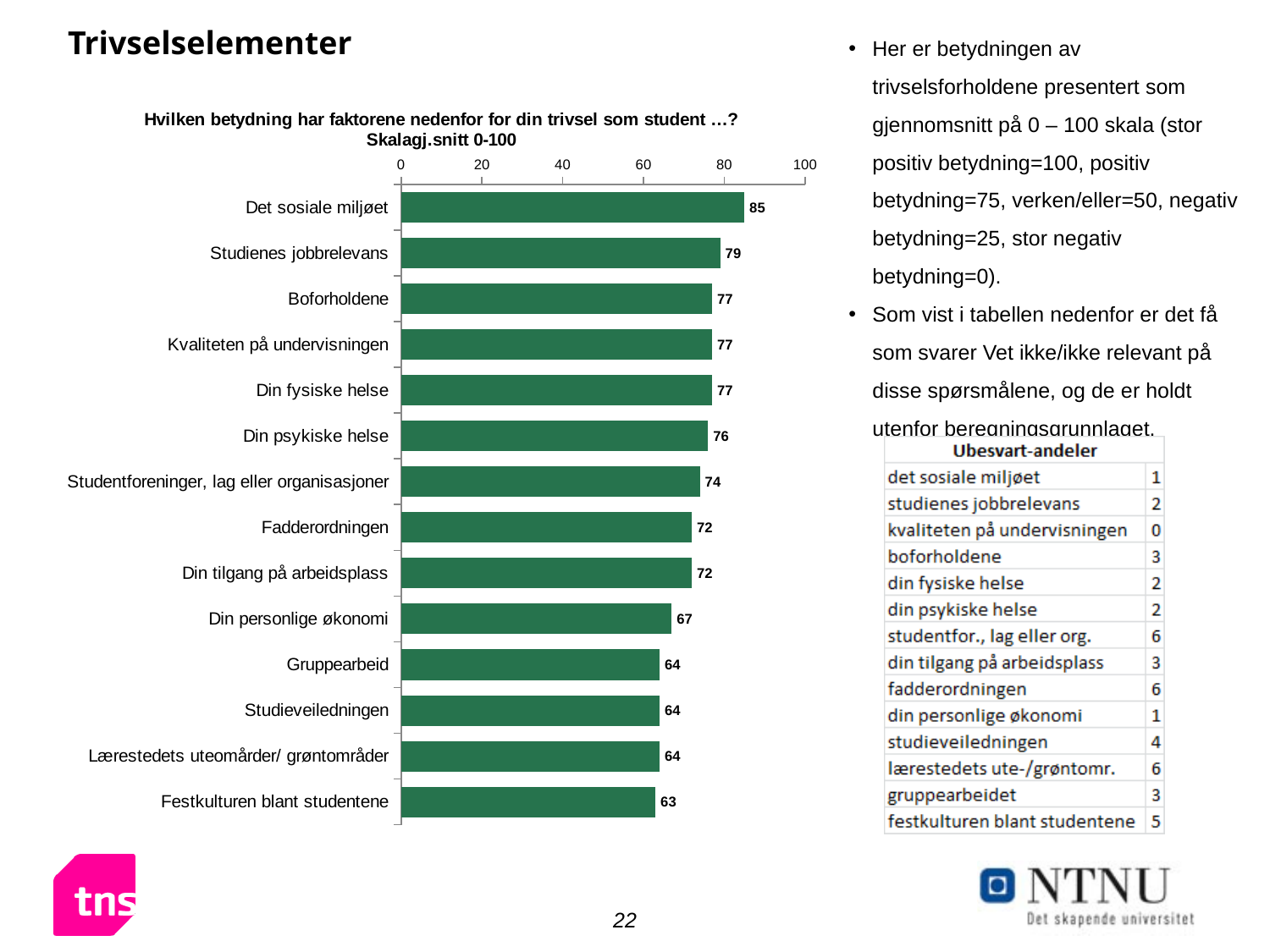
What is the difference between the values for Studienes jobbrelevans and Din personlige økonomi? 12 What kind of chart is shown on the slide? Bar chart What is the difference between the values for Det sosiale miljøet and Festkulturen blant studentene? 22 Which category has the highest value? Det sosiale miljøet What is the value for Det sosiale miljøet? 85 Which category has the lowest value? Festkulturen blant studentene How many categories are shown in the chart? 14 What is the maximum value shown on the chart's axis? 100 What is the value for Din personlige økonomi? 67 What is the value for Studentforeninger, lag eller organisasjoner? 74 Which is larger, the value for Din psykiske helse or the value for Gruppearbeid? Din psykiske helse What is the value for Fadderordningen? 72